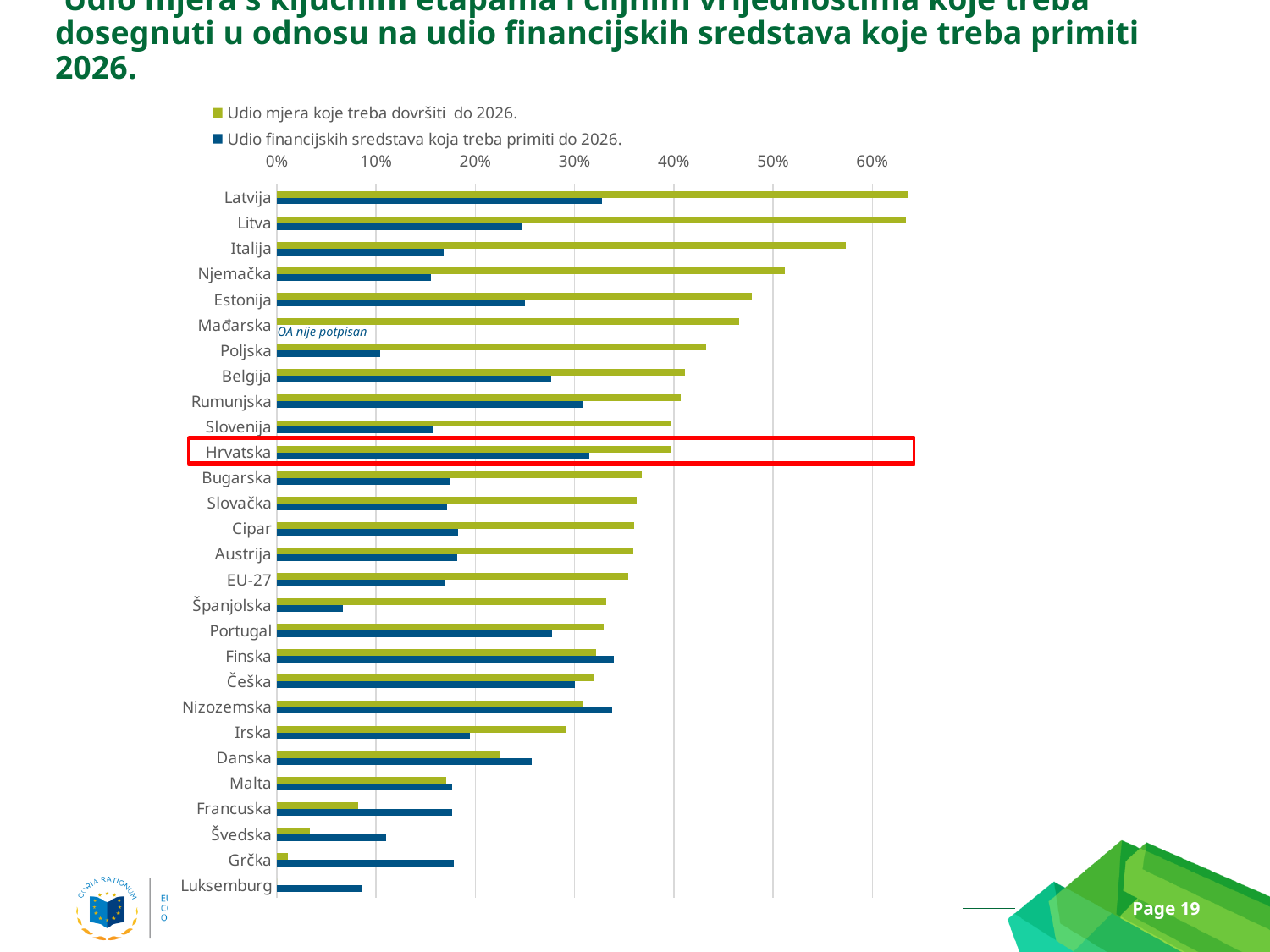
Is the value of 'Udio mjera koje treba dovršiti do 2026.' for Italija greater or less than 50%? greater Is the value of 'Udio mjera koje treba dovršiti do 2026.' for Grčka greater or less than 10%? less Which country is highlighted with a red box in the chart? Hrvatska For Francuska, which series has the larger value: 'Udio mjera koje treba dovršiti do 2026.' or 'Udio financijskih sredstava koja treba primiti do 2026.'? Udio financijskih sredstava koja treba primiti do 2026. Is the value of 'Udio financijskih sredstava koja treba primiti do 2026.' for Španjolska greater or less than 10%? less How many categories (countries/groups) are listed on the vertical axis of the chart? 28 How many series does the legend list? 2 What kind of chart is shown on the slide? Bar chart What annotation is shown next to Mađarska in the chart? OA nije potpisan Which has the larger value for 'Udio mjera koje treba dovršiti do 2026.': Latvija or Italija? Latvija